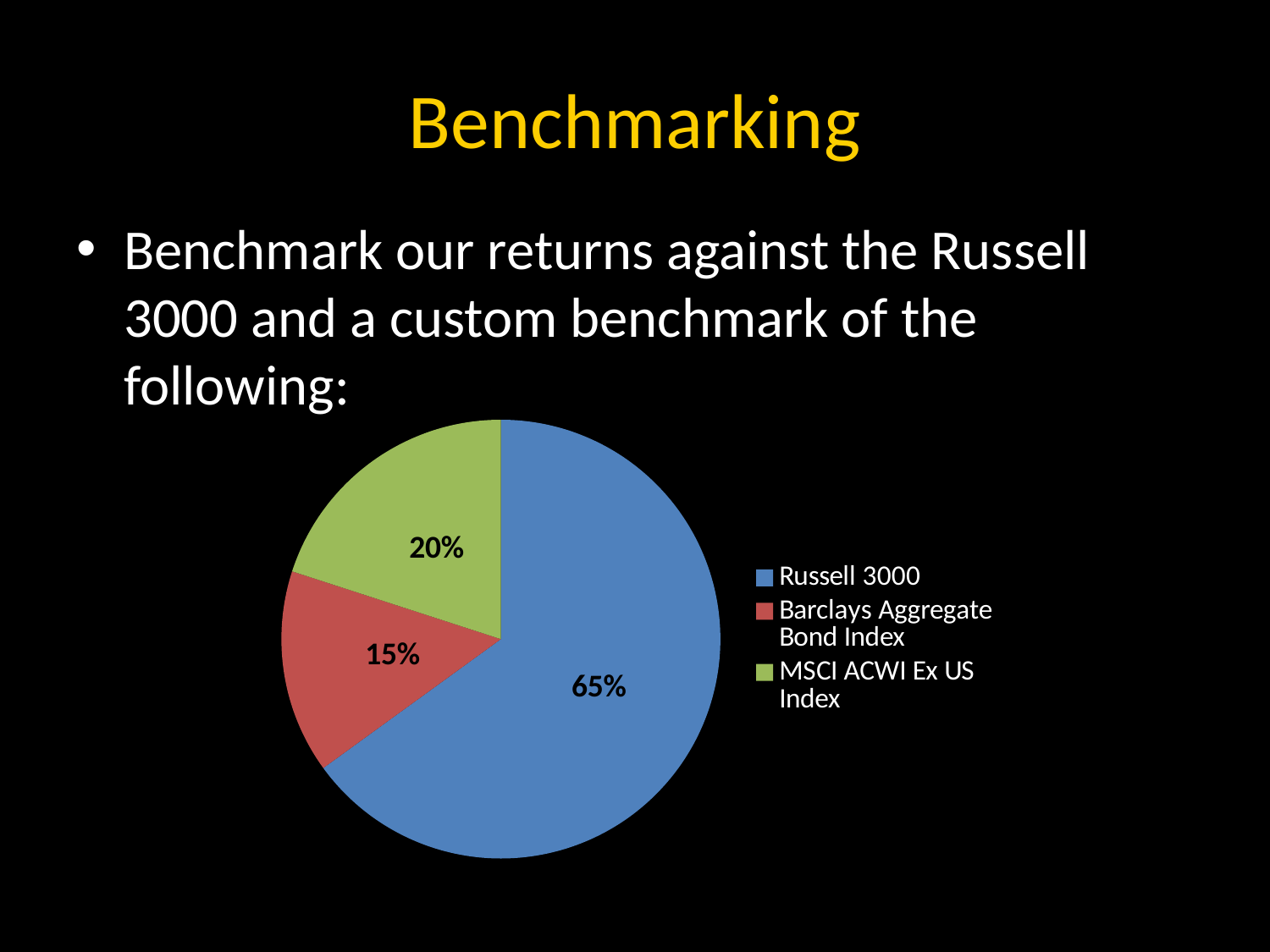
Which is larger, the MSCI ACWI Ex US Index slice or the Barclays Aggregate Bond Index slice? MSCI ACWI Ex US Index What share of the pie does Russell 3000 have? 65% What is the difference in percentage points between the Russell 3000 slice and the MSCI ACWI Ex US Index slice? 45 Which category has the largest slice of the pie? Russell 3000 What colour is the Russell 3000 slice? Blue What share of the pie does the MSCI ACWI Ex US Index have? 20% How many slices does the pie chart have? 3 Which category has the smallest slice of the pie? Barclays Aggregate Bond Index What kind of chart is shown on the slide? Pie chart Which category is shown in green in the legend? MSCI ACWI Ex US Index What is the difference in percentage points between the MSCI ACWI Ex US Index slice and the Barclays Aggregate Bond Index slice? 5 What share of the pie does the Barclays Aggregate Bond Index have? 15%